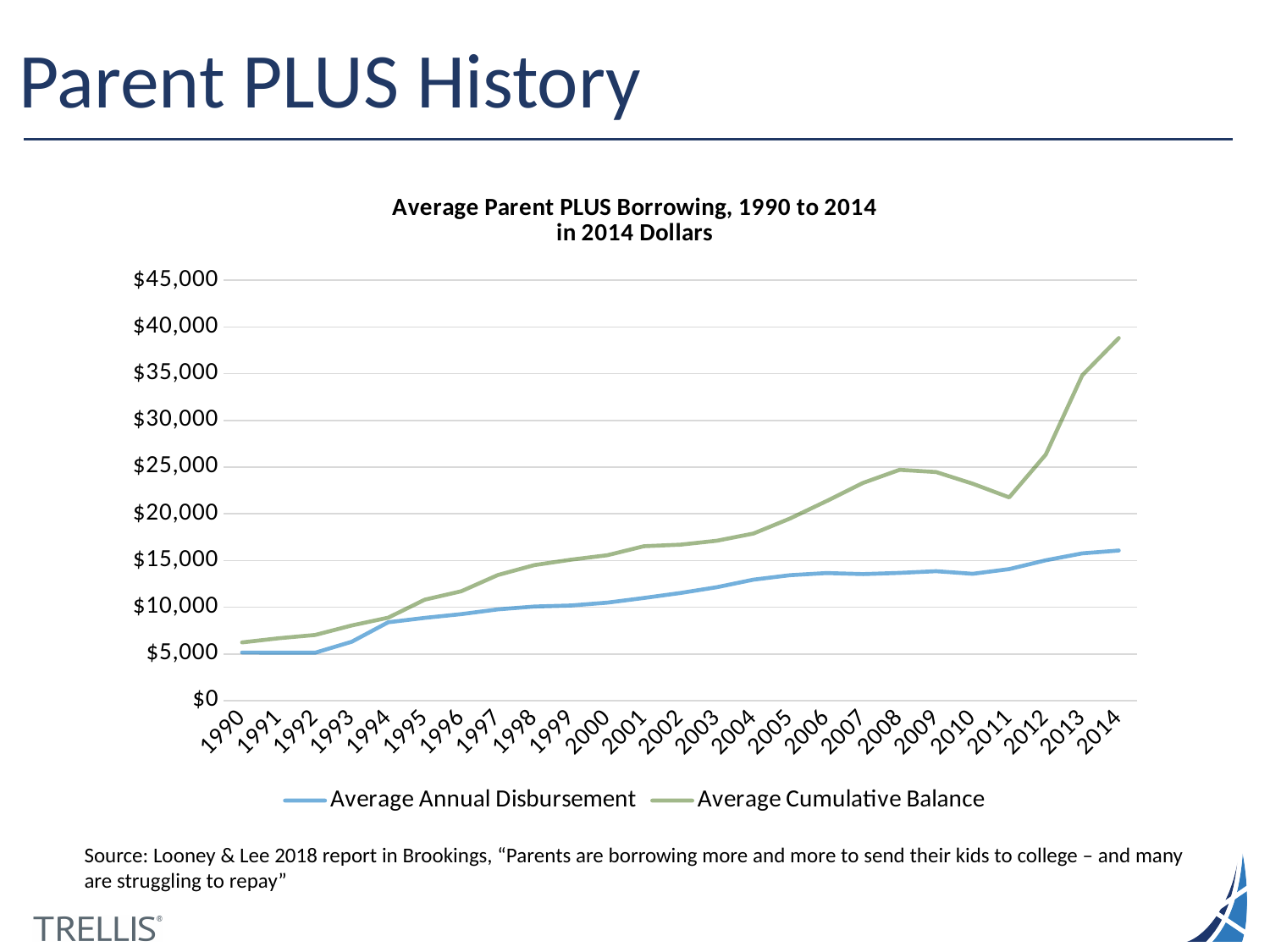
What kind of chart is shown on the slide? Line chart How many years are plotted along the x axis? 25 Is the Average Cumulative Balance in 2013 greater or less than $30,000? greater In which year is the Average Cumulative Balance highest? 2014 Is the Average Cumulative Balance in 2014 greater or less than $35,000? greater In which year is the Average Cumulative Balance lowest? 1990 Is the Average Annual Disbursement in 1990 greater or less than $10,000? less How many series does the legend list? 2 What is the title of the chart? Average Parent PLUS Borrowing, 1990 to 2014 in 2014 Dollars In 2014, which is larger: the Average Annual Disbursement or the Average Cumulative Balance? Average Cumulative Balance Which series is drawn in green? Average Cumulative Balance